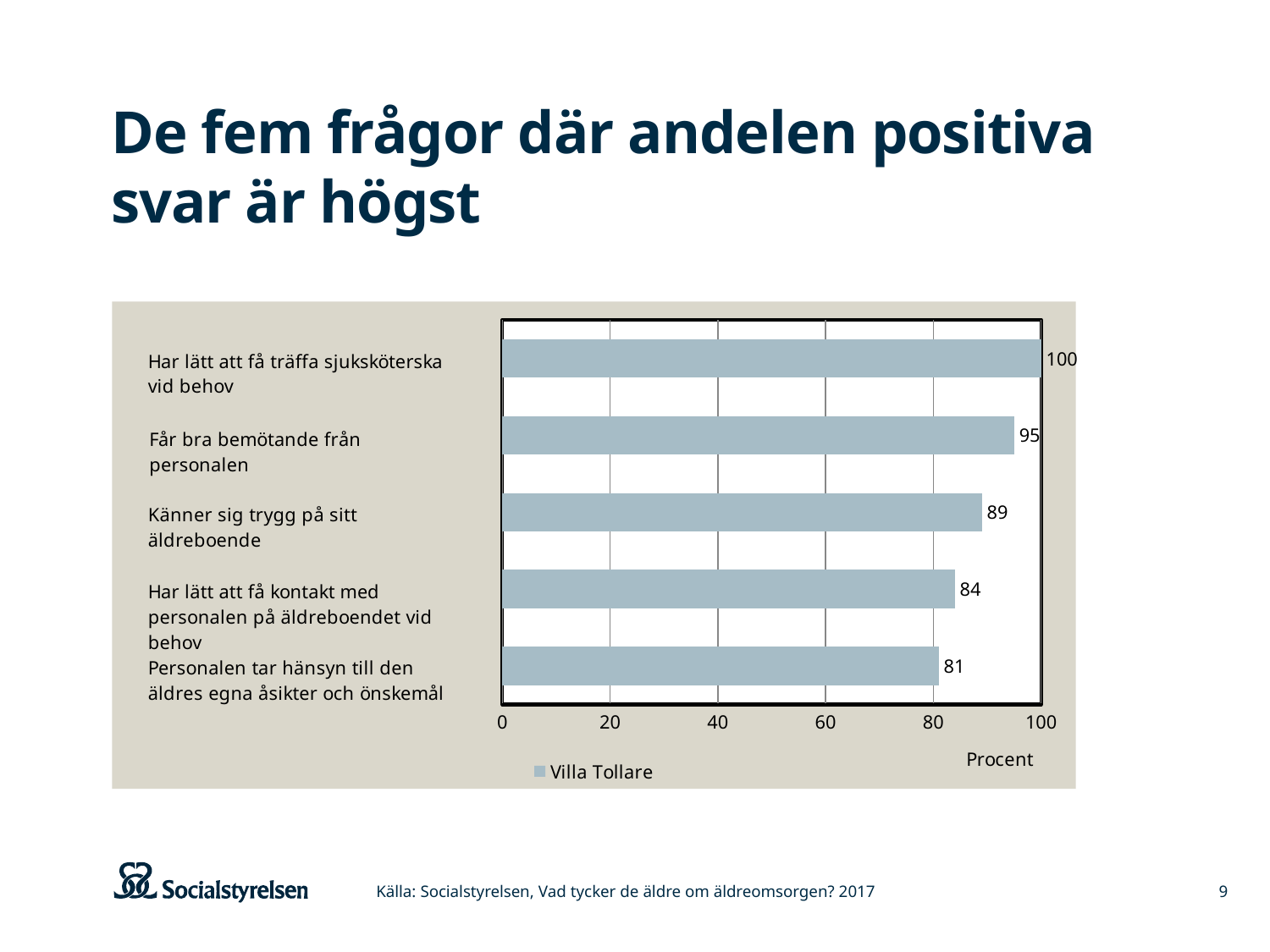
What kind of chart is shown on the slide? bar chart What series name does the legend show? Villa Tollare Which category has the highest value? Har lätt att få träffa sjuksköterska vid behov What is the value for "Känner sig trygg på sitt äldreboende"? 89 What is the difference between the values for "Får bra bemötande från personalen" and "Har lätt att få kontakt med personalen på äldreboendet vid behov"? 11 What is the value for "Har lätt att få träffa sjuksköterska vid behov"? 100 How many categories are shown in the chart? 5 What is the value for "Personalen tar hänsyn till den äldres egna åsikter och önskemål"? 81 What is the value for "Får bra bemötande från personalen"? 95 Which category has the lowest value? Personalen tar hänsyn till den äldres egna åsikter och önskemål Is the value for "Personalen tar hänsyn till den äldres egna åsikter och önskemål" greater or less than 80? greater Which is larger: the value for "Känner sig trygg på sitt äldreboende" or the value for "Har lätt att få kontakt med personalen på äldreboendet vid behov"? Känner sig trygg på sitt äldreboende